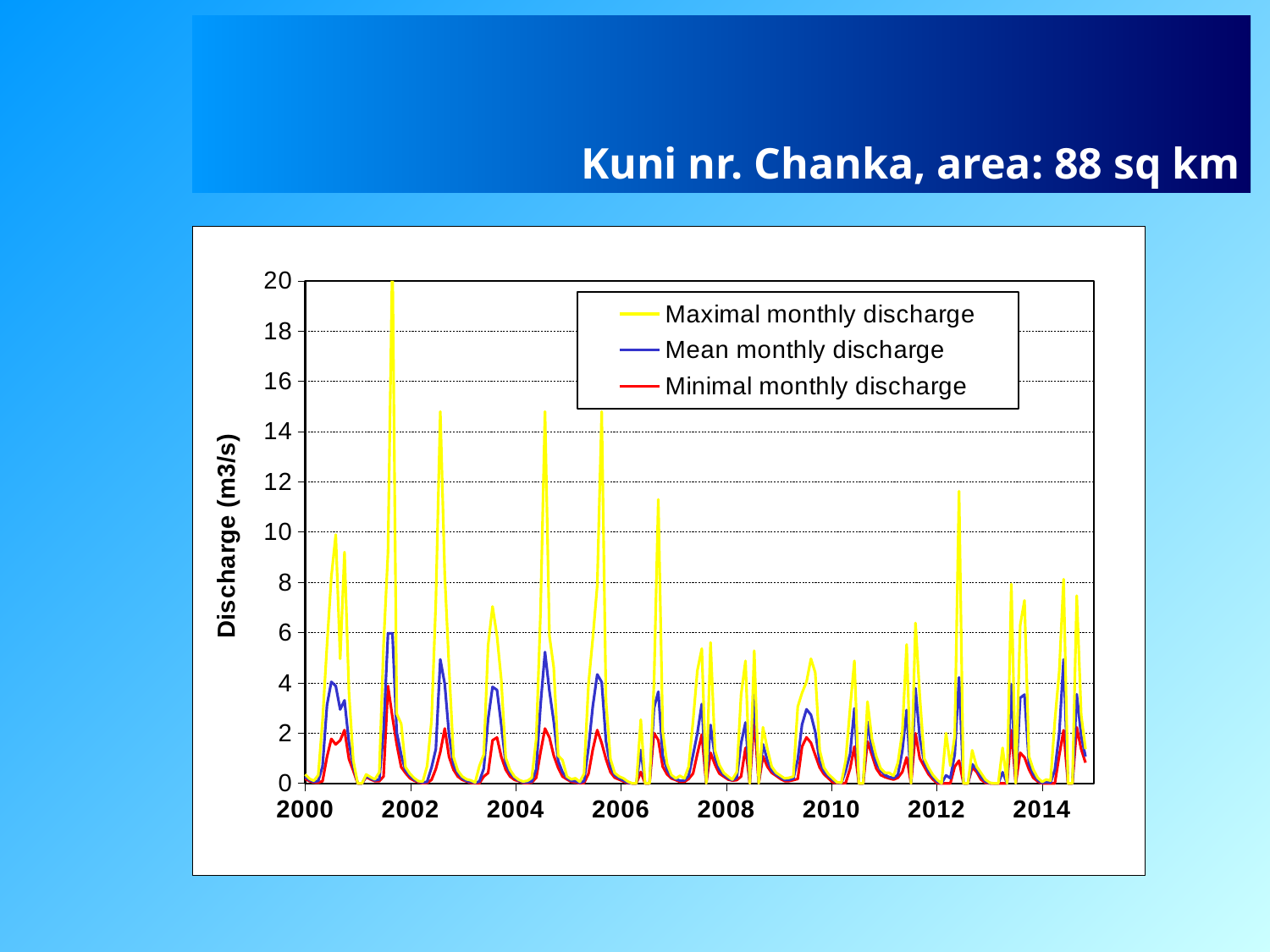
What kind of chart is shown on the slide? line chart Which series stays lowest throughout the chart? Minimal monthly discharge Is the peak of the Maximal monthly discharge series around 2004-2005 greater or less than 12? greater How many series does the legend list? 3 Is the highest peak of the Maximal monthly discharge series (around 2001-2002) greater or less than 18? greater How many year labels are shown on the x axis? 8 What is the title of the y axis? Discharge (m3/s) Which colour is used for the Mean monthly discharge series? blue Which series reaches the highest value on the chart? Maximal monthly discharge Is the peak of the Maximal monthly discharge series around 2012 greater or less than 10? greater Do the peaks of the Maximal monthly discharge series generally rise or fall from 2000 to 2014? fall